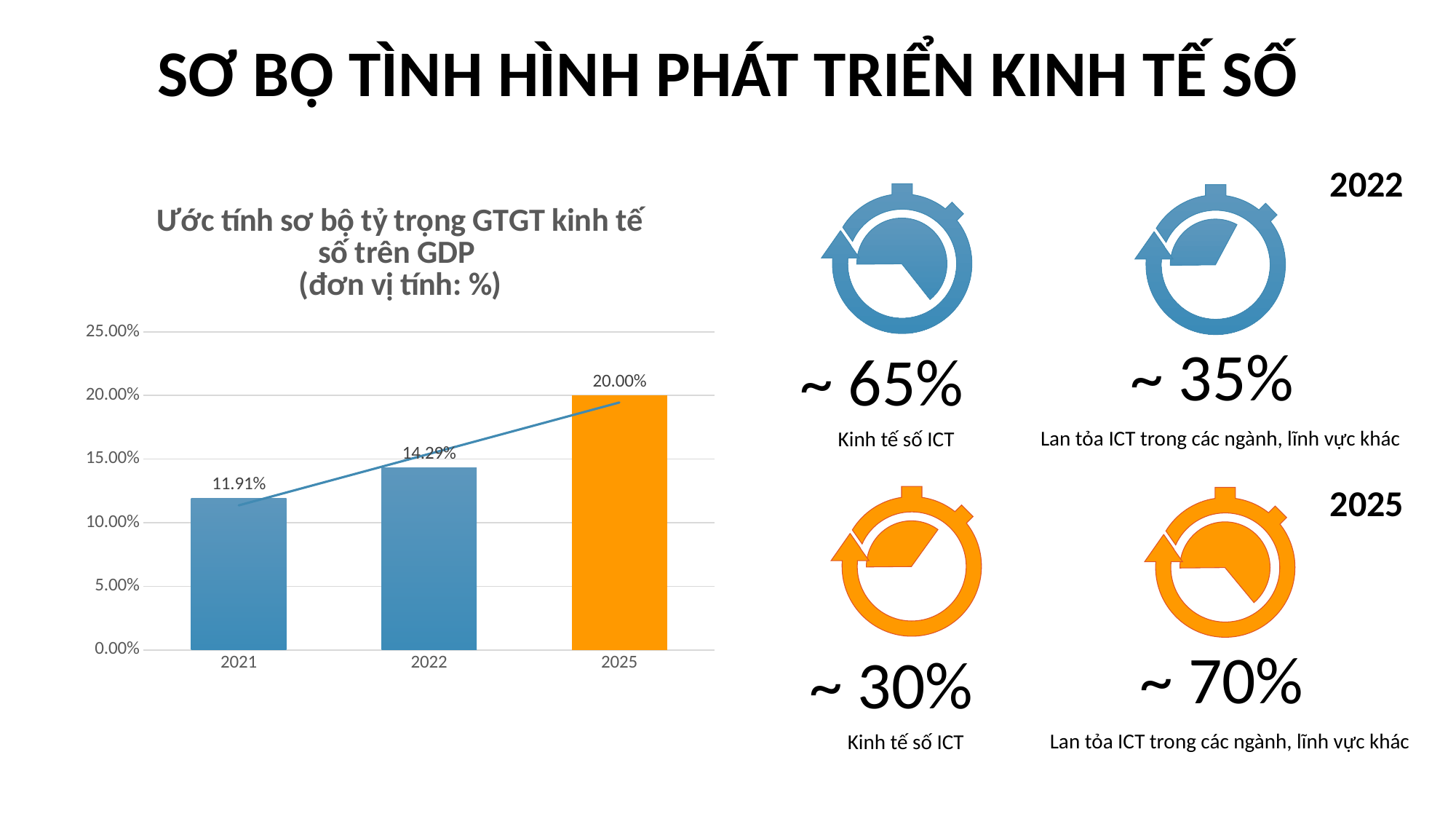
What is the difference between the values for 2022 and 2021 in the bar chart? 2.38% How many years are shown on the x axis of the bar chart? 3 Which year has the lowest value in the bar chart? 2021 What is the value for 2025 in the bar chart? 20.00% What kind of chart is shown on the slide? bar chart What is the value for 2022 in the bar chart? 14.29% Do the values in the bar chart rise or fall from 2021 to 2025? rise What is the difference between the values for 2025 and 2021 in the bar chart? 8.09% What is the value for 2021 in the bar chart? 11.91% Is the value for 2022 in the bar chart greater or less than 15.00%? less Which is larger in the bar chart, the value for 2022 or the value for 2021? 2022 Which year has the highest value in the bar chart? 2025